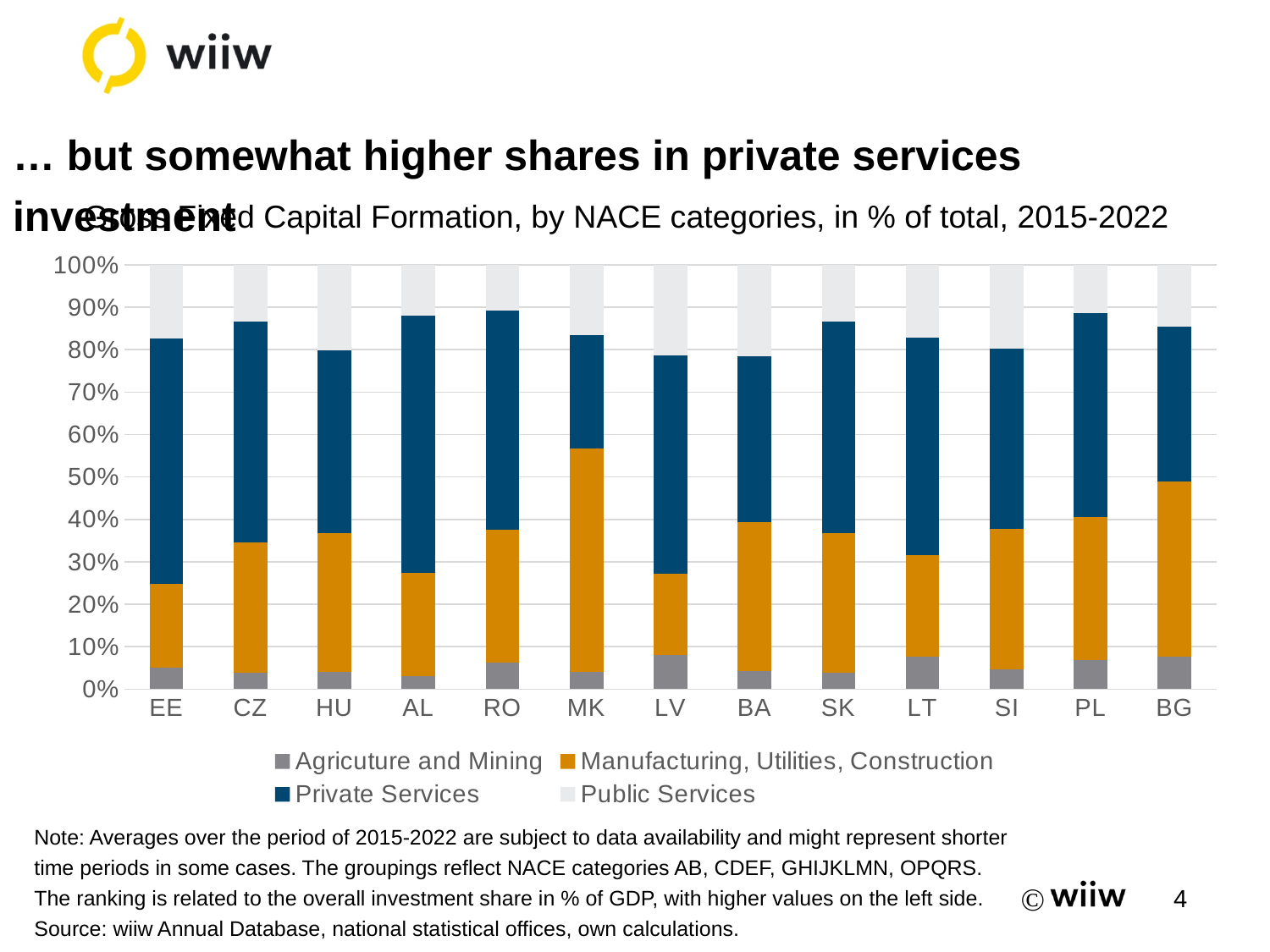
Which legend entry is shown in orange? Manufacturing, Utilities, Construction Is the Agriculture and Mining share for LV greater or less than 10%? less Which has the larger Public Services share, LV or RO? LV How many countries are shown on the x axis of the chart? 13 Is the top of the Private Services segment for CZ greater or less than 80%? greater How many series does the chart's legend list? 4 Which has the larger Manufacturing, Utilities, Construction share, MK or EE? MK Which country has the largest share for Manufacturing, Utilities, Construction? MK Is the top of the Manufacturing, Utilities, Construction segment for MK greater or less than 50%? greater What is the title of the chart? Gross Fixed Capital Formation, by NACE categories, in % of total, 2015-2022 What kind of chart is shown on the slide? stacked bar chart